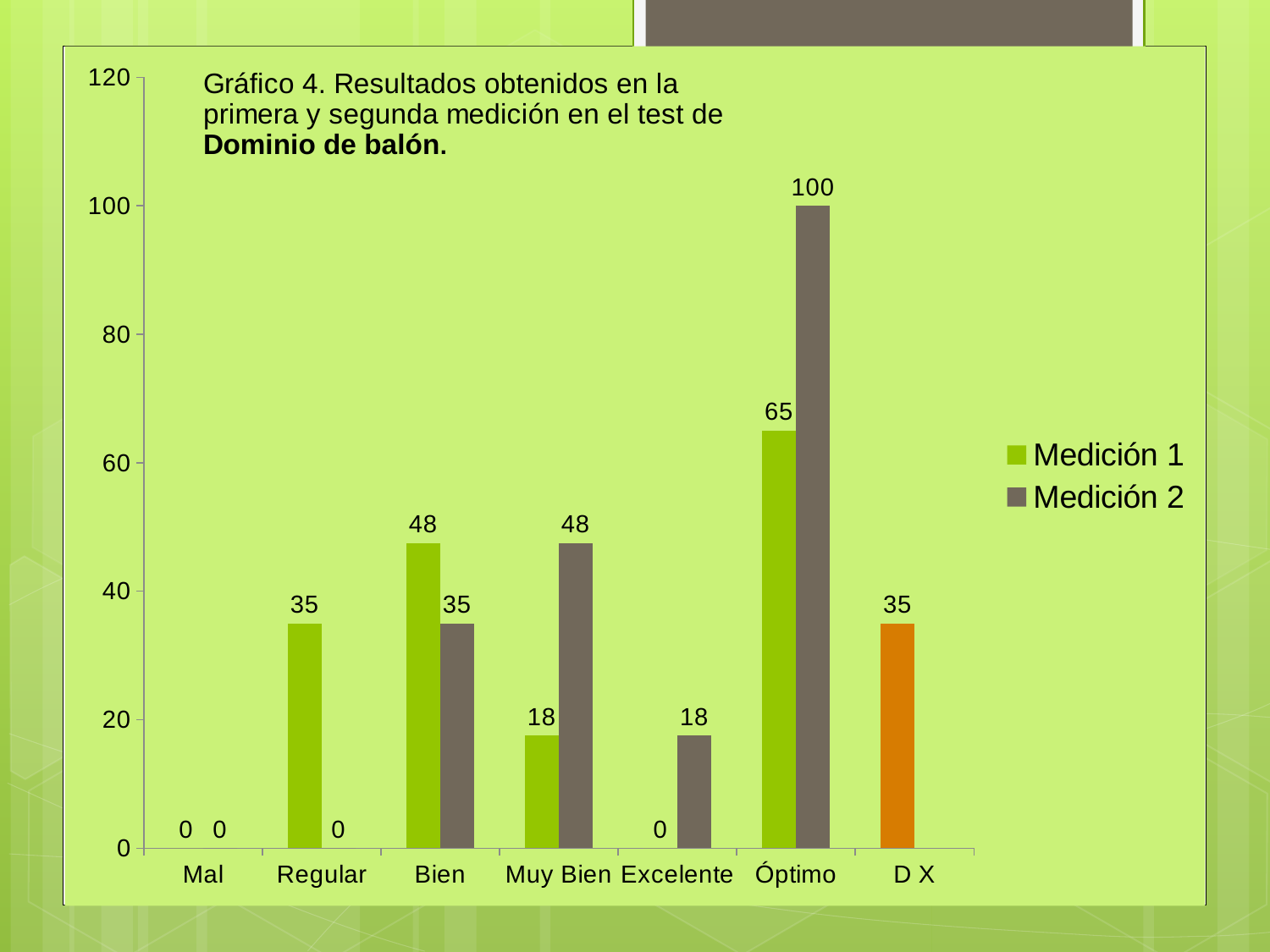
In the Bien category, which is larger, Medición 1 or Medición 2? Medición 1 What is the value for Medición 2 in the Excelente category? 18 Which category has the highest Medición 2 value? Óptimo Which category has the highest Medición 1 value? Óptimo What is the value for Medición 2 in the Óptimo category? 100 What is the difference between Medición 2 and Medición 1 in the Óptimo category? 35 How many series does the legend list? 2 How many categories are shown on the x axis? 7 What is the value for Medición 1 in the Regular category? 35 What type of chart is shown on the slide? Bar chart What is the value for Medición 1 in the Bien category? 48 In the Muy Bien category, which is larger, Medición 1 or Medición 2? Medición 2